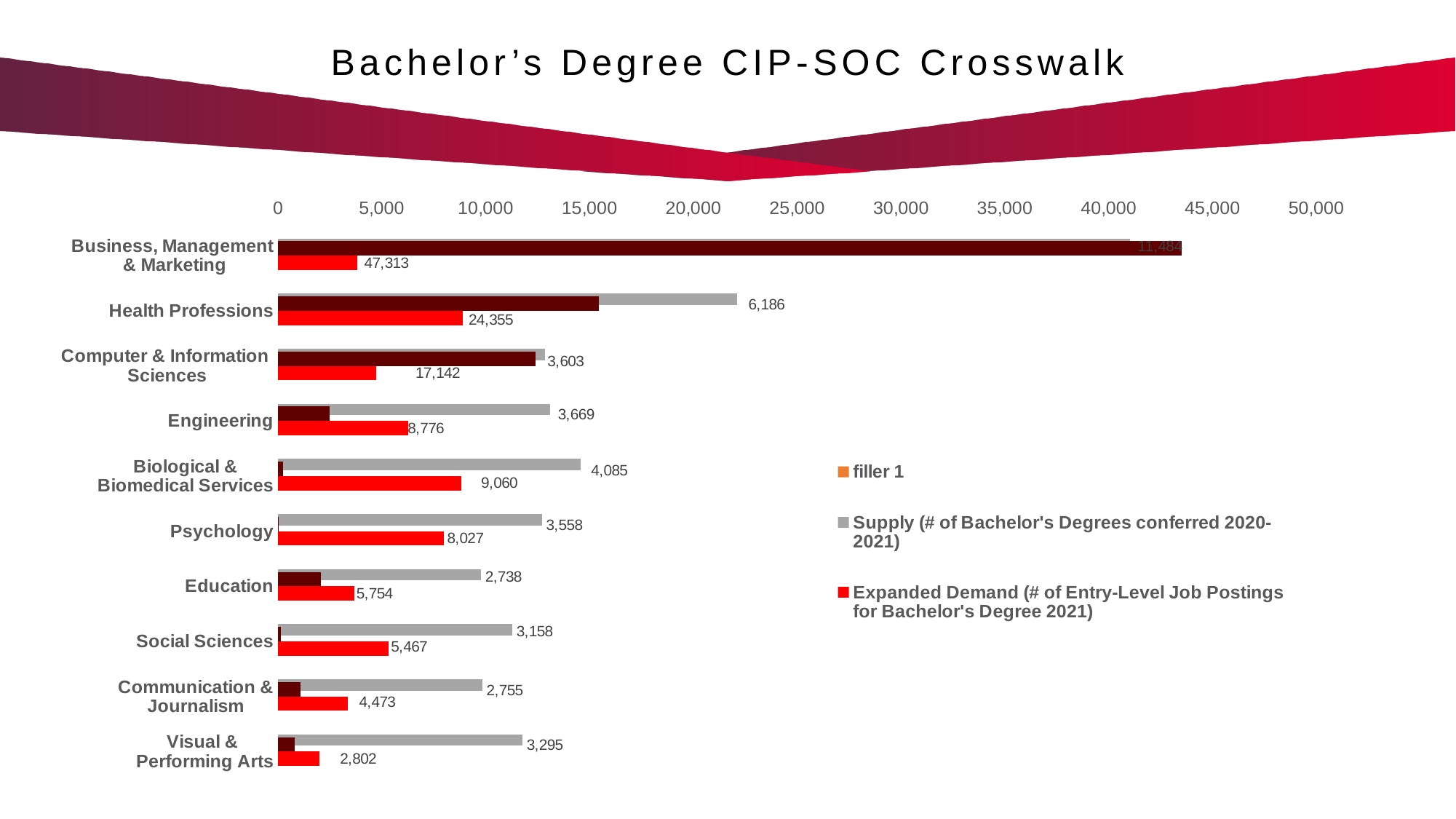
What data label is printed next to the gray Supply bar for Biological & Biomedical Services? 4,085 What data label is printed next to the red Expanded Demand bar for Psychology? 8,027 How many degree categories are listed on the chart? 10 What is the title of the slide? Bachelor's Degree CIP-SOC Crosswalk What data label is printed next to the gray Supply bar for Engineering? 3,669 What kind of chart is shown on the slide? bar chart What is the difference between the Expanded Demand labels for Health Professions (24,355) and Computer & Information Sciences (17,142)? 7,213 What data label is printed next to the red Expanded Demand bar for Health Professions? 24,355 How many series does the chart legend list? 3 What data label is printed next to the red Expanded Demand bar for Visual & Performing Arts? 2,802 According to the printed Expanded Demand labels, which is larger: Education or Social Sciences? Education Which colour represents the Expanded Demand series in the legend? red